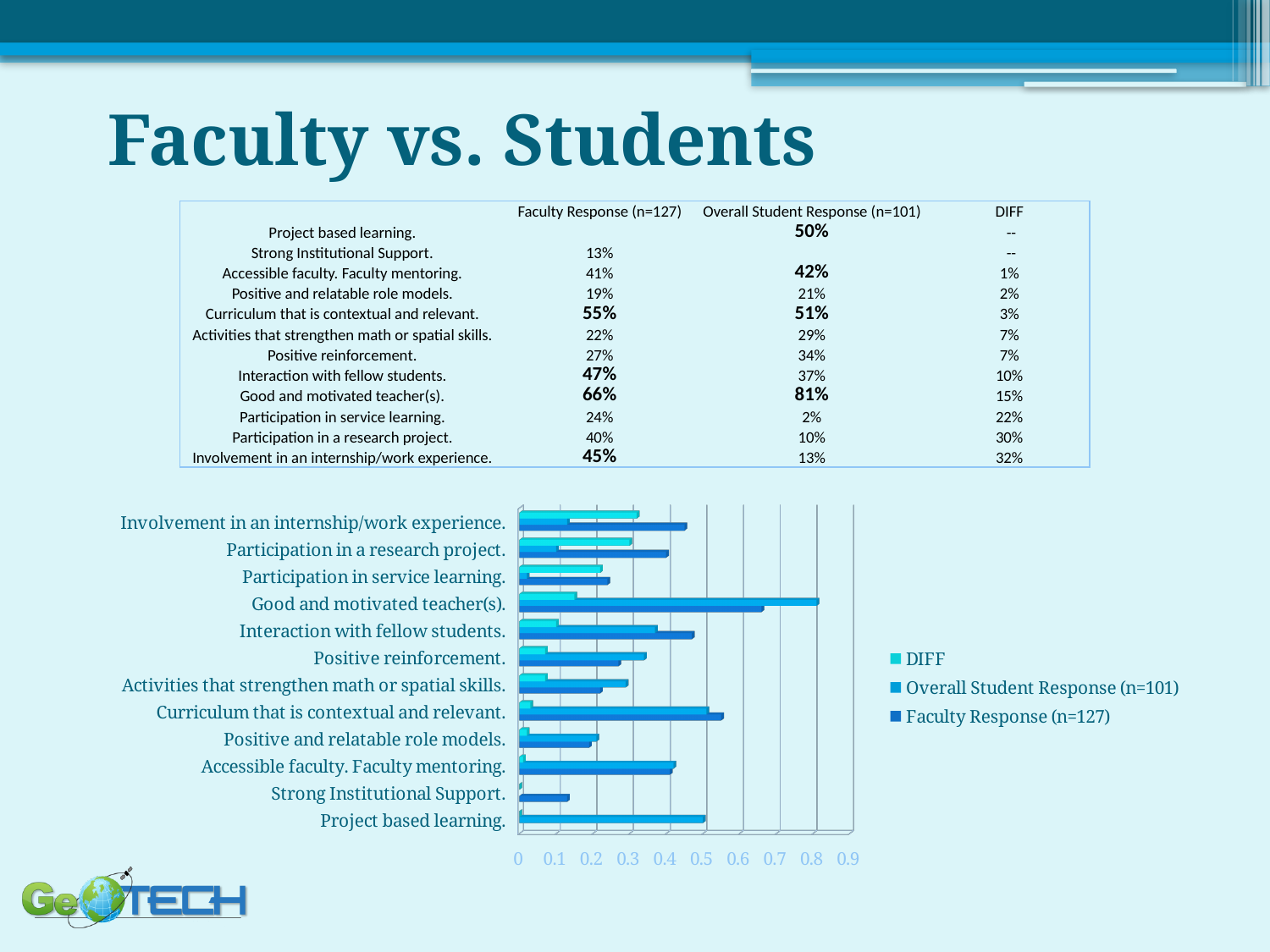
Which category has the highest Overall Student Response (n=101) value? Good and motivated teacher(s). Is the Overall Student Response bar for Good and motivated teacher(s) greater or less than 0.7 on the chart's axis? greater How many series does the chart legend list? 3 What is the difference (DIFF) between the Faculty Response and Overall Student Response for Participation in a research project? 30% What type of chart is shown on the slide? bar chart Is the Overall Student Response bar for Participation in service learning greater or less than 0.1 on the chart's axis? less What is the Faculty Response (n=127) value for Good and motivated teacher(s)? 66% For Curriculum that is contextual and relevant, which is larger: the Faculty Response or the Overall Student Response? Faculty Response Which category has the largest DIFF value? Involvement in an internship/work experience. What is the Overall Student Response (n=101) value for Participation in a research project? 10% How many categories are plotted on the chart's vertical axis? 12 What is the Faculty Response (n=127) value for Curriculum that is contextual and relevant? 55%